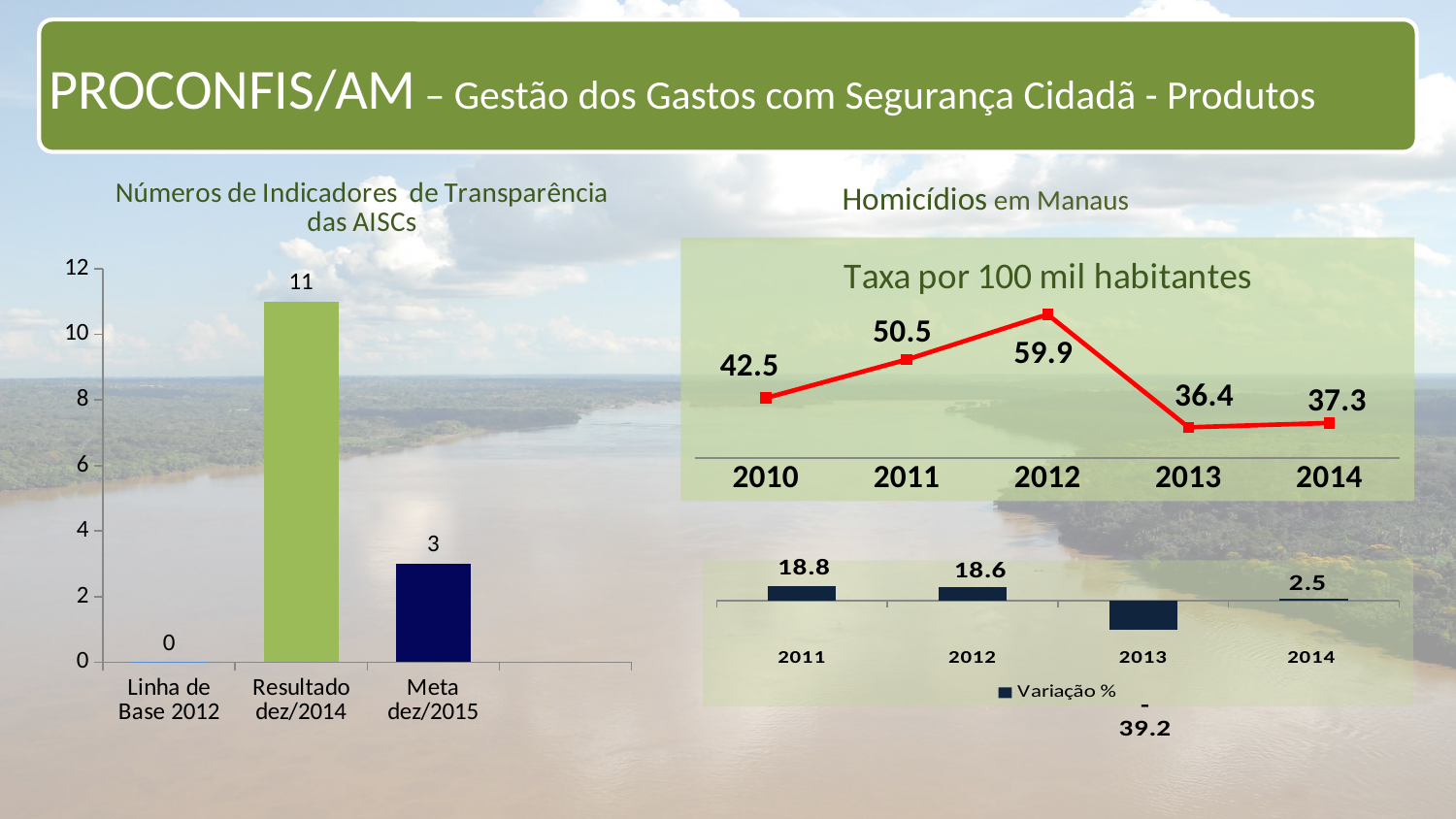
In the chart 'Números de Indicadores de Transparência das AISCs', which category has the highest value? Resultado dez/2014 In the chart 'Taxa por 100 mil habitantes', what is the value for 2012? 59.9 In the 'Variação %' chart at the bottom right, which year has the highest value? 2011 What kind of chart is 'Números de Indicadores de Transparência das AISCs'? bar chart In the chart 'Números de Indicadores de Transparência das AISCs', what is the value for Resultado dez/2014? 11 In the chart 'Taxa por 100 mil habitantes', how many years are plotted? 5 In the chart 'Números de Indicadores de Transparência das AISCs', what is the value for Meta dez/2015? 3 In the 'Variação %' chart at the bottom right, what is the value for 2013? -39.2 In the chart 'Taxa por 100 mil habitantes', what is the difference between 2012 and 2013? 23.5 In the chart 'Taxa por 100 mil habitantes', which year has the lowest value? 2013 In the chart 'Taxa por 100 mil habitantes', what is the value for 2010? 42.5 In the chart 'Números de Indicadores de Transparência das AISCs', what is the difference between Resultado dez/2014 and Meta dez/2015? 8